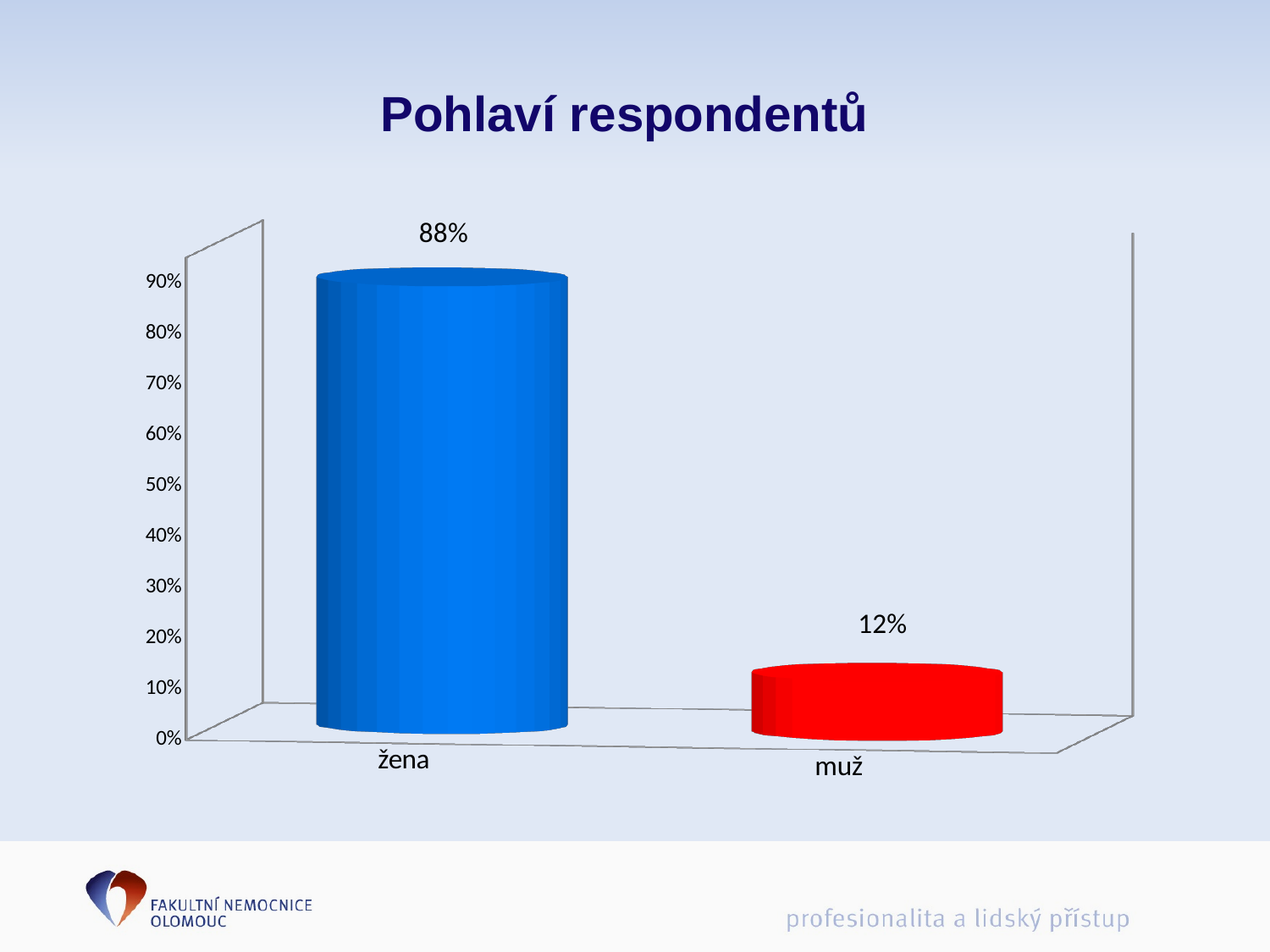
What is the title of the slide? Pohlaví respondentů Which category has the highest value? žena What kind of chart is shown on the slide? bar chart What is the value for muž? 12% What is the value for žena? 88% Is the value for žena greater or less than 80%? greater Which is larger, the value for žena or the value for muž? žena What is the difference between the values for žena and muž? 76% What colour is the bar for muž? red How many categories are shown on the chart? 2 Which category has the lowest value? muž Is the value for muž greater or less than 20%? less